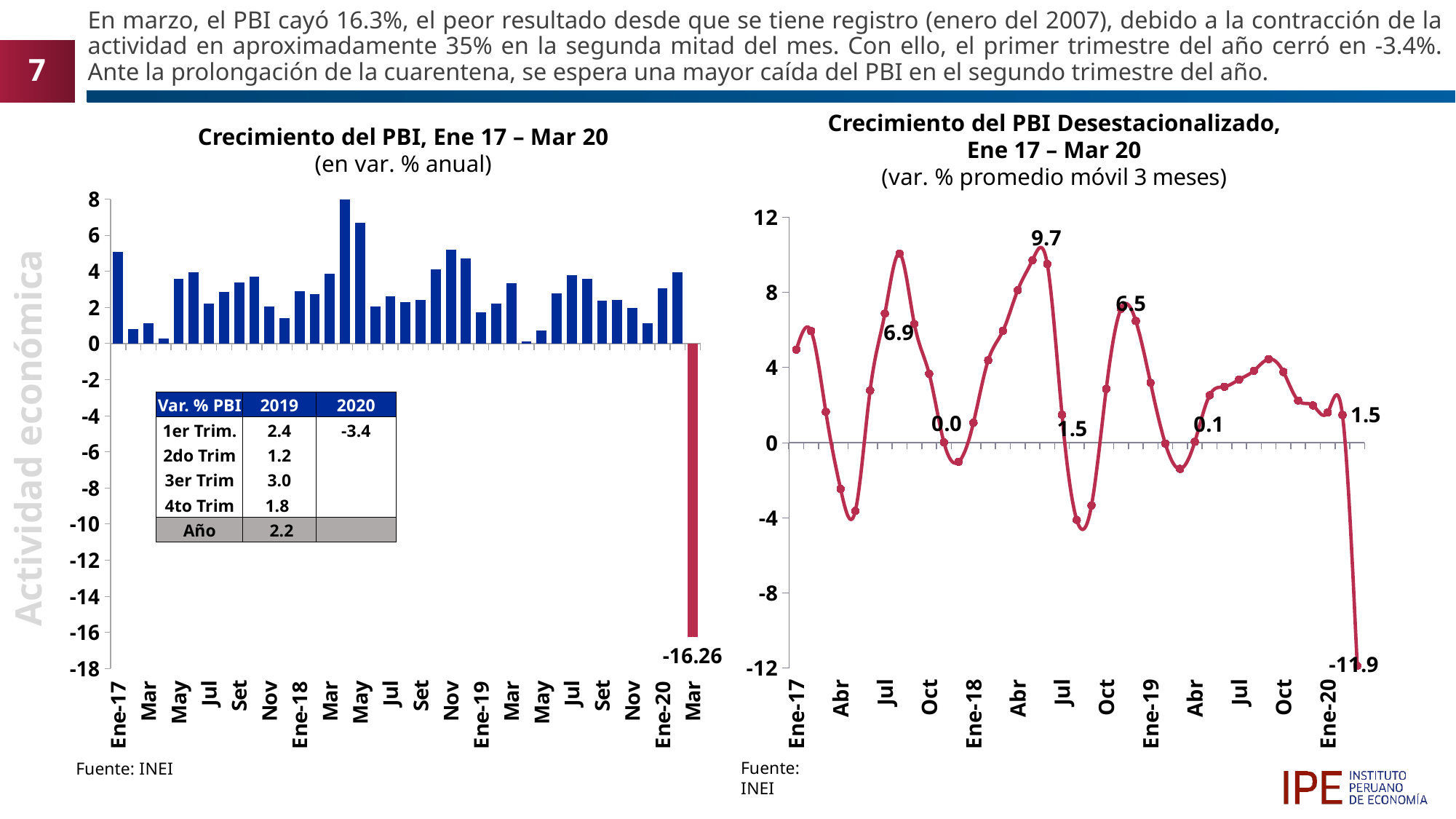
What kind of chart is the left chart, 'Crecimiento del PBI, Ene 17 – Mar 20'? Bar chart What source is cited below both charts? INEI In the right chart 'Crecimiento del PBI Desestacionalizado', what is the highest labelled value? 9.7 In the right chart 'Crecimiento del PBI Desestacionalizado', what is the difference between the labelled peaks 9.7 and 6.9? 2.8 In the table inside the left chart, what is the Var. % PBI for Año in 2019? 2.2 In the left chart 'Crecimiento del PBI, Ene 17 – Mar 20', is the value for Ene-17 greater or less than 4? greater In the right chart 'Crecimiento del PBI Desestacionalizado', which labelled peak is larger, 6.9 or 6.5? 6.9 In the left chart 'Crecimiento del PBI, Ene 17 – Mar 20', what value is labelled for Mar-20? -16.26 In the table inside the left chart, what is the Var. % PBI for 1er Trim. in 2020? -3.4 In the left chart 'Crecimiento del PBI, Ene 17 – Mar 20', which month has the lowest bar? Mar-20 What kind of chart is the right chart, 'Crecimiento del PBI Desestacionalizado'? Line chart In the right chart 'Crecimiento del PBI Desestacionalizado', what is the labelled value at the last point (Mar-20)? -11.9